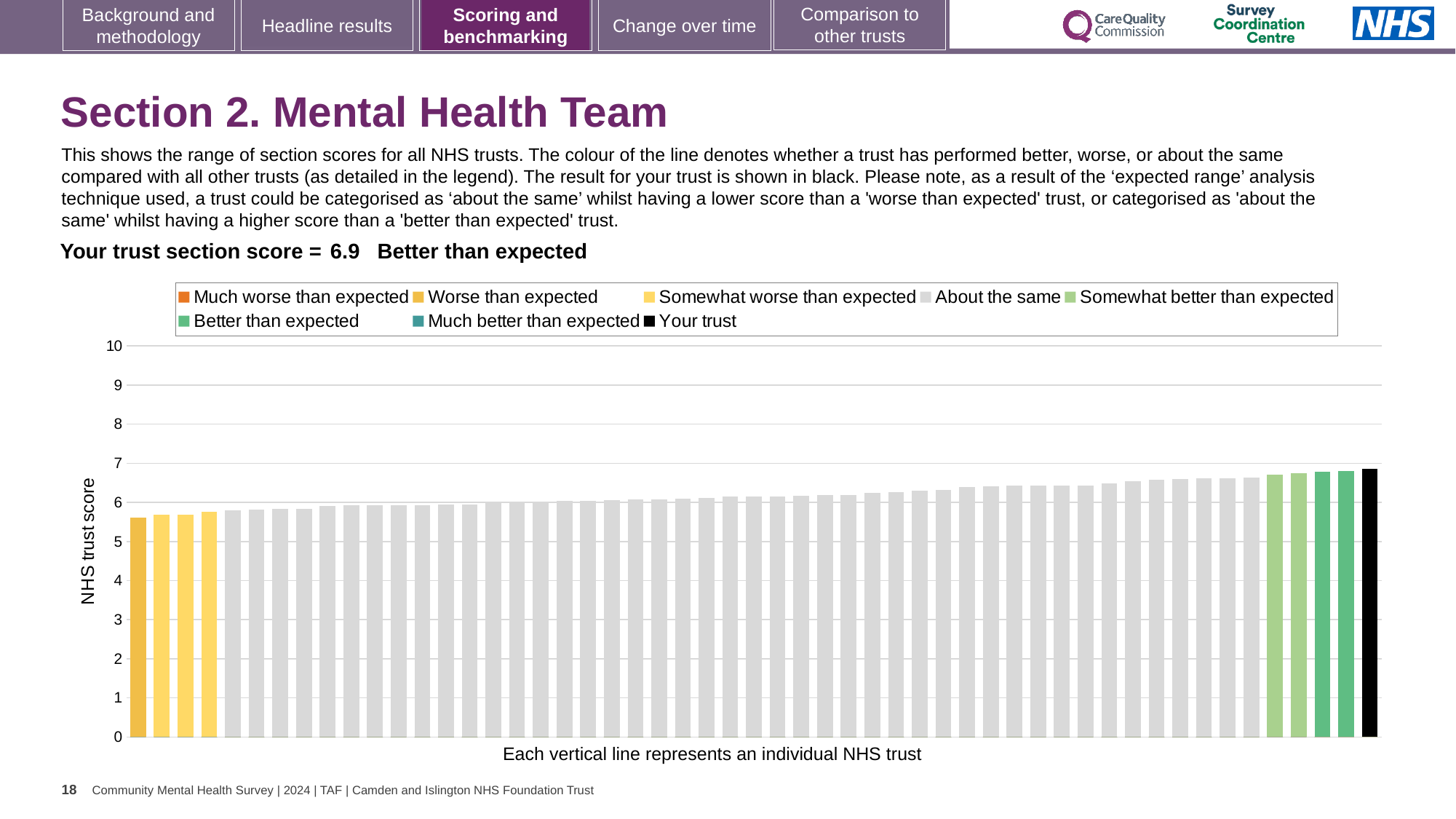
What is the section score for your trust shown on the slide? 6.9 According to the legend, what colour represents 'Your trust'? black How many bars are coloured in the 'Better than expected' green shade? 2 What is the label on the vertical axis of the chart? NHS trust score How many entries does the chart legend list? 8 Do the bar values rise or fall from left to right across the chart? rise Is the value of the tallest bar greater or less than 7? less Is the value of the leftmost (lowest) bar greater or less than 5? greater Which performance category is your trust placed in for this section? Better than expected Is the value of the black bar (your trust) greater or less than 6? greater What kind of chart is shown on the slide? bar chart